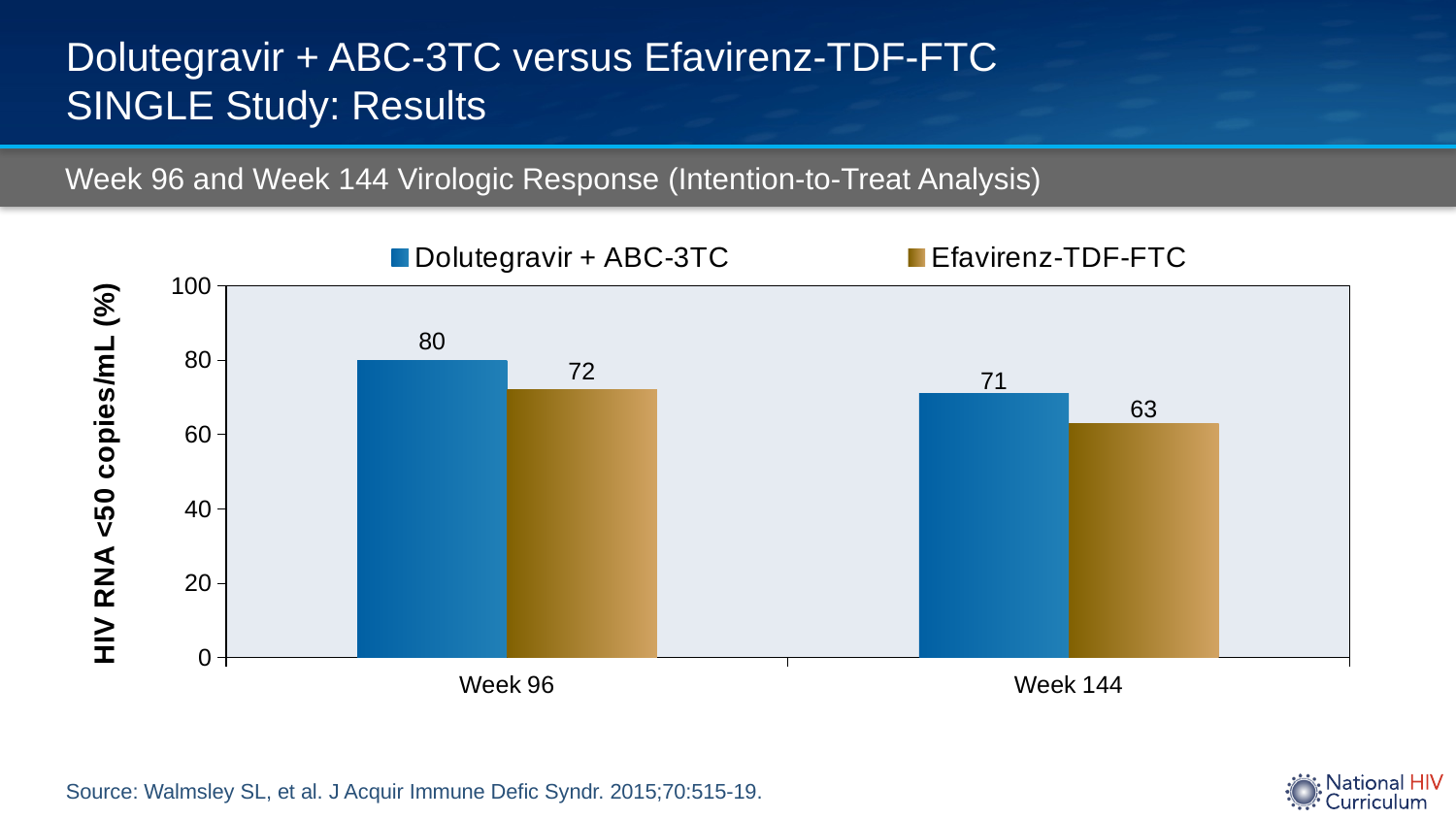
What is the difference between Dolutegravir + ABC-3TC and Efavirenz-TDF-FTC at Week 96? 8 What is the value for Efavirenz-TDF-FTC at Week 144? 63 Which series has the lowest value at Week 144? Efavirenz-TDF-FTC What is the value for Efavirenz-TDF-FTC at Week 96? 72 Which is larger: Efavirenz-TDF-FTC at Week 96 or Dolutegravir + ABC-3TC at Week 144? Efavirenz-TDF-FTC at Week 96 Do the Efavirenz-TDF-FTC values rise or fall from Week 96 to Week 144? Fall What is the value for Dolutegravir + ABC-3TC at Week 96? 80 Which series has the highest value at Week 96? Dolutegravir + ABC-3TC What is the difference between the Dolutegravir + ABC-3TC values at Week 96 and Week 144? 9 What is the value for Dolutegravir + ABC-3TC at Week 144? 71 What kind of chart is shown on the slide? Bar chart How many series does the legend list? 2